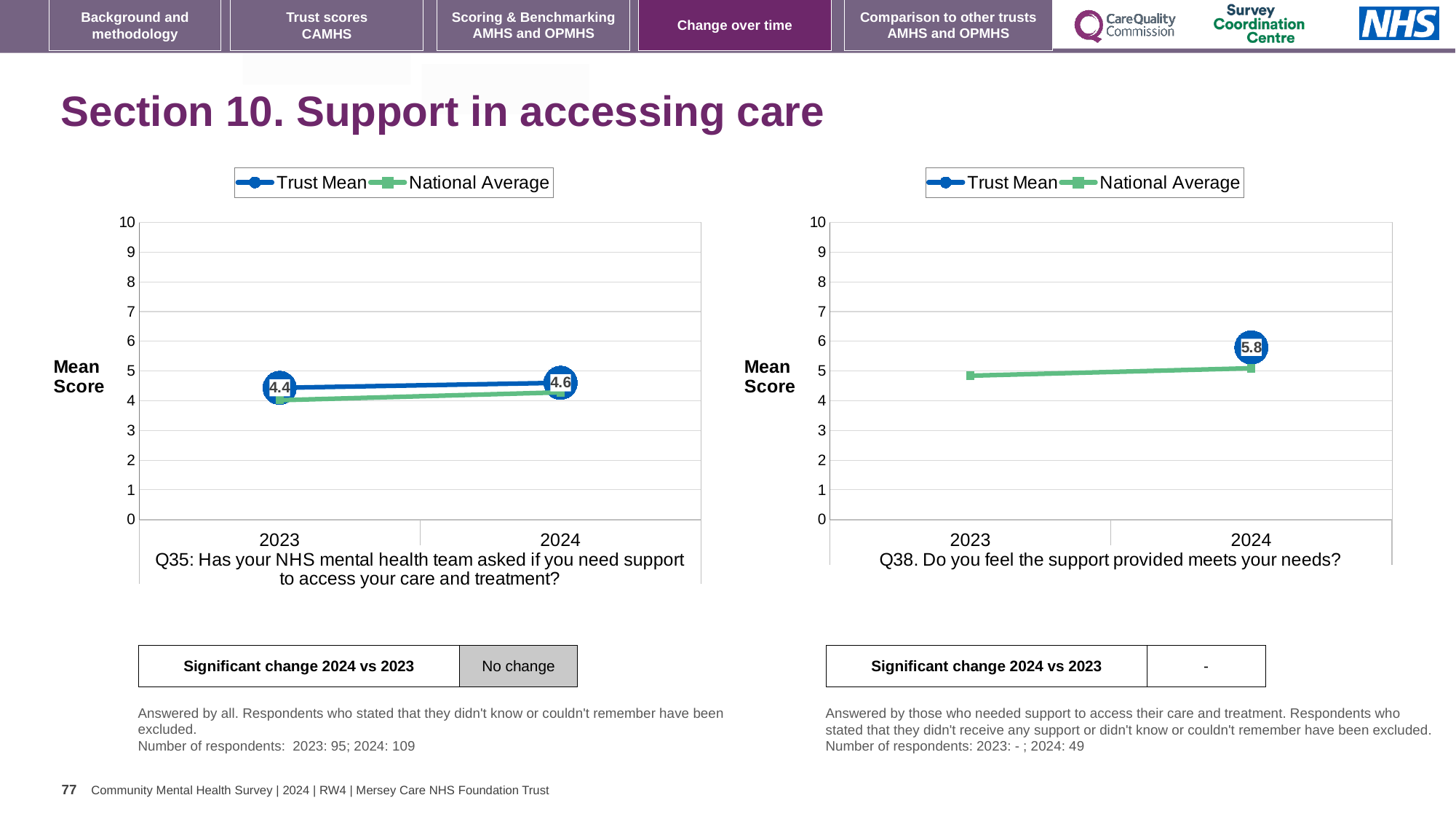
On the Q38 chart, is the National Average for 2023 greater or less than 6? less On the Q35 chart, by how much did the Trust Mean change from 2023 to 2024? 0.2 How many series does the legend of the Q35 chart list? 2 On the Q35 chart, does the Trust Mean rise or fall from 2023 to 2024? rise On the Q35 chart, what is the Trust Mean score for 2024? 4.6 On the Q35 chart, is the Trust Mean for 2024 greater or less than 5? less On the Q38 chart, what is the Trust Mean score for 2024? 5.8 On the Q38 chart, does the National Average rise or fall from 2023 to 2024? rise How many years are shown on the x axis of the Q38 chart? 2 On the Q35 chart, what is the Trust Mean score for 2023? 4.4 On the Q38 chart, in 2024, which is higher: the Trust Mean or the National Average? Trust Mean What type of chart is used for Q35? line chart